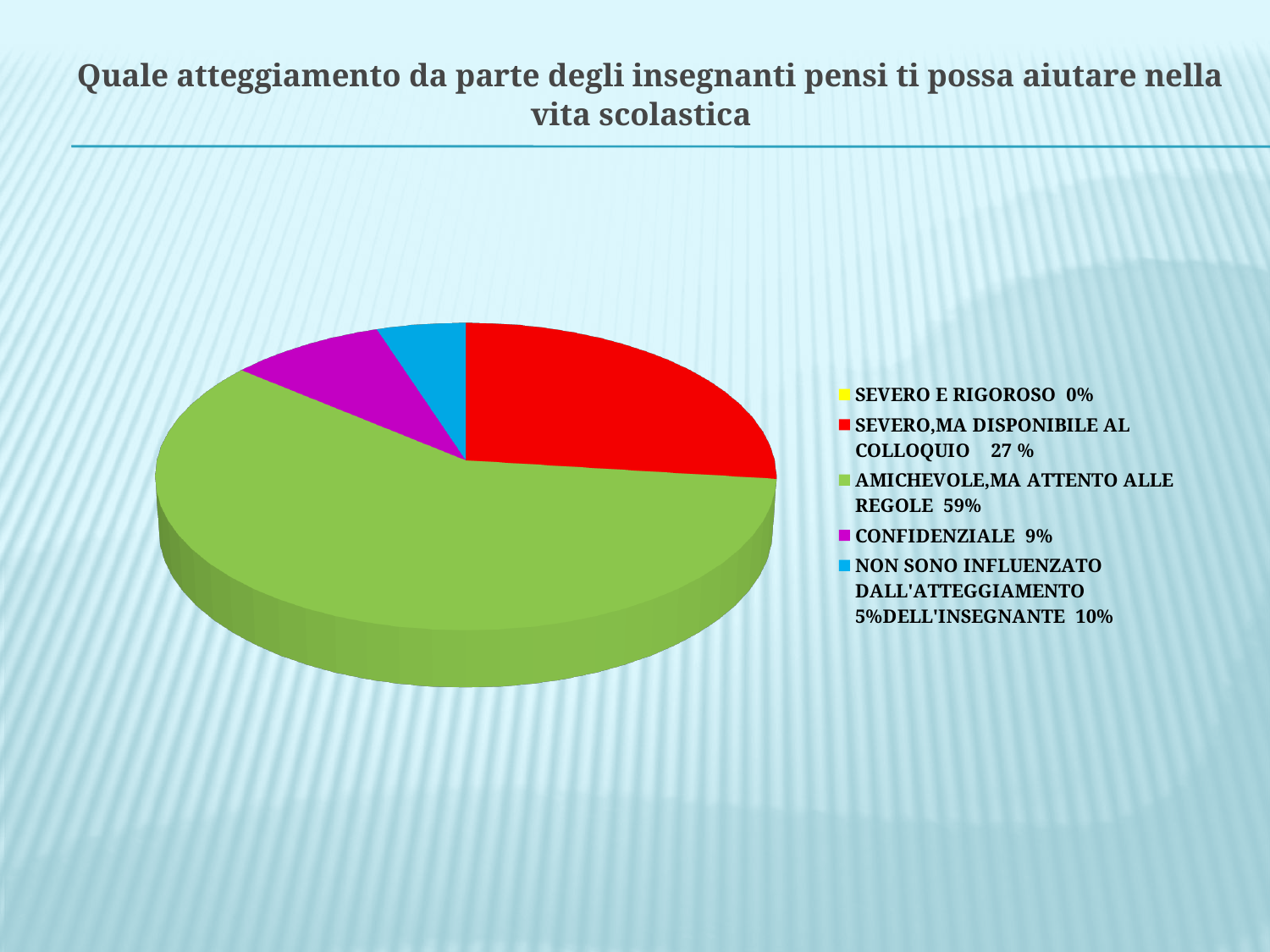
What colour is the slice for CONFIDENZIALE? purple What percentage is shown for SEVERO E RIGOROSO? 0% Which category has the largest share of the pie? AMICHEVOLE,MA ATTENTO ALLE REGOLE What colour is the slice for AMICHEVOLE,MA ATTENTO ALLE REGOLE? green By how many percentage points does AMICHEVOLE,MA ATTENTO ALLE REGOLE exceed SEVERO,MA DISPONIBILE AL COLLOQUIO? 32 Which category has the smallest share of the pie? SEVERO E RIGOROSO What percentage is shown for SEVERO,MA DISPONIBILE AL COLLOQUIO? 27 % What kind of chart is shown on the slide? pie chart How many categories does the legend of the pie chart list? 5 What percentage is shown for CONFIDENZIALE? 9% Which has a larger share: SEVERO,MA DISPONIBILE AL COLLOQUIO or CONFIDENZIALE? SEVERO,MA DISPONIBILE AL COLLOQUIO What percentage is shown for AMICHEVOLE,MA ATTENTO ALLE REGOLE? 59%